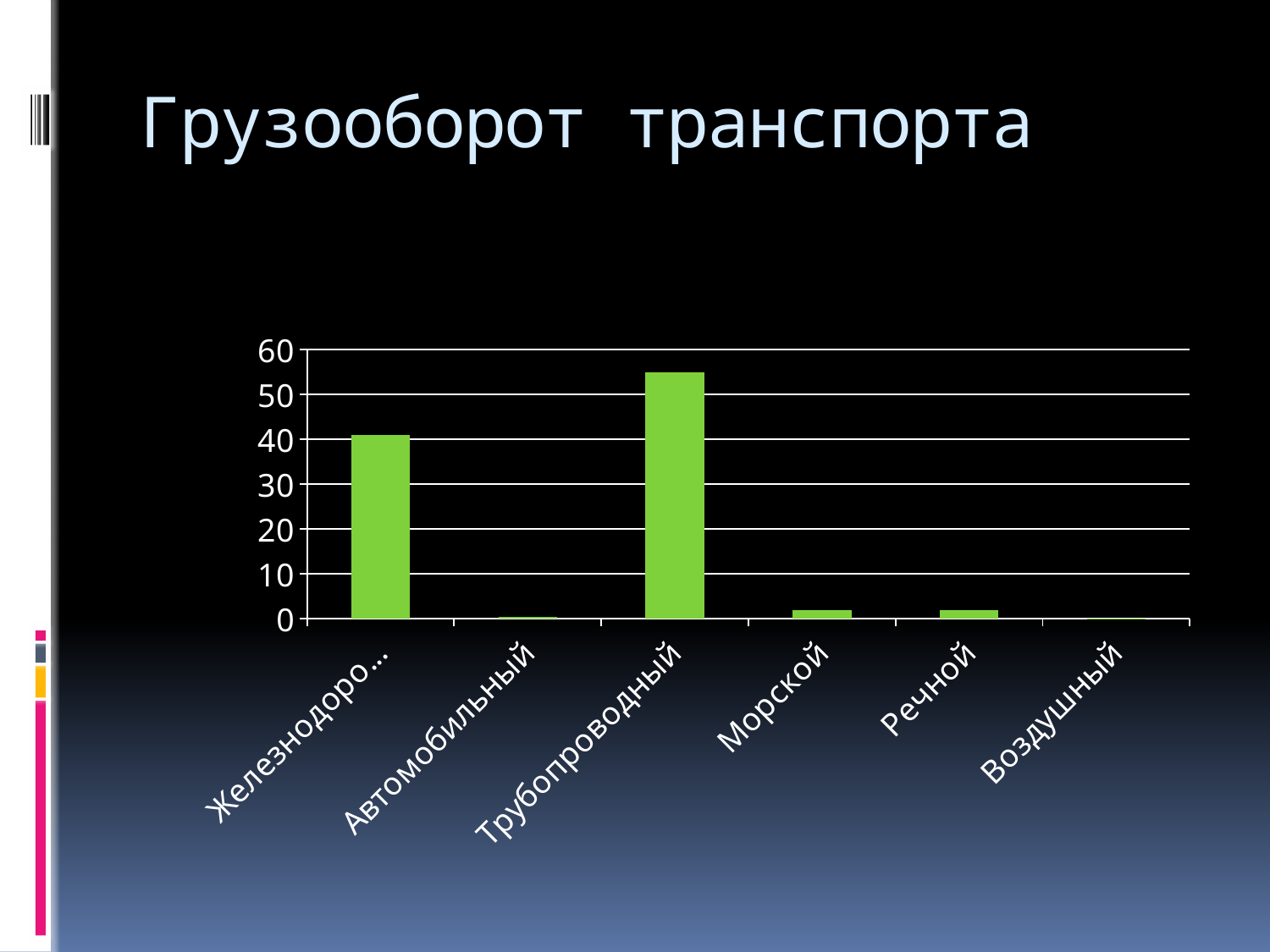
What kind of chart is shown on the slide? bar chart Is the value for Речной greater or less than 10? less Which is larger, the value for Морской or the value for Автомобильный? Морской Which category has the highest bar in the chart? Трубопроводный How many categories are plotted on the x axis of the chart? 6 Is the value for the leftmost category (Железнодоро…) greater or less than 50? less What is the highest value shown on the vertical axis of the chart? 60 What is the title of the chart on the slide? Грузооборот транспорта Is the value for Морской greater or less than 10? less Which is larger, the value for Трубопроводный or the value for the leftmost category (Железнодоро…)? Трубопроводный